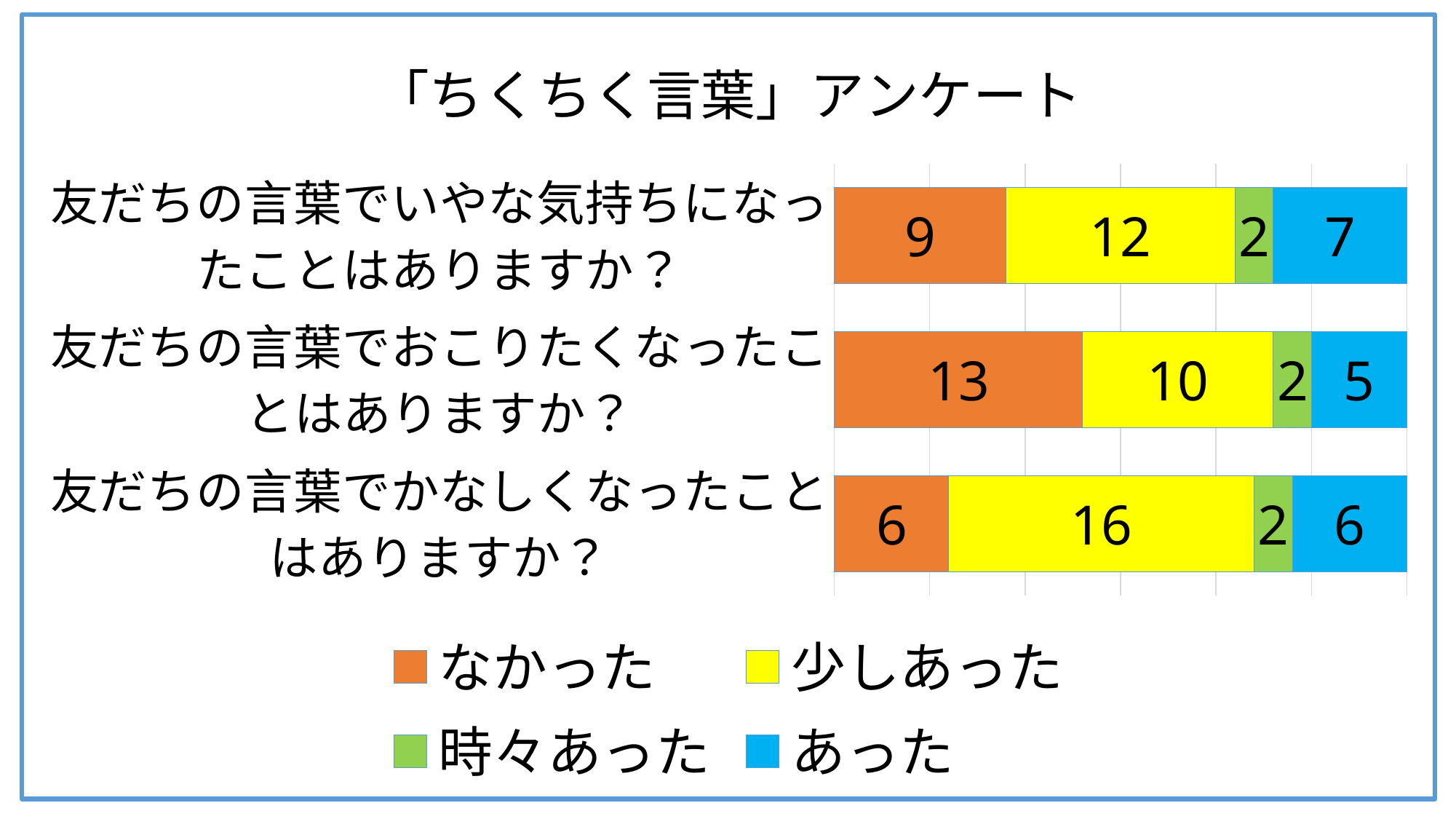
How many categories (questions) are plotted in the chart? 3 Which is larger for 友だちの言葉でいやな気持ちになったことはありますか？: なかった or 少しあった? 少しあった What is the value of 少しあった for 友だちの言葉でかなしくなったことはありますか？? 16 What is the total of the stacked bar for 友だちの言葉でおこりたくなったことはありますか？? 30 What type of chart is shown on the slide? stacked bar chart How many series does the legend list? 4 What is the title of the chart? 「ちくちく言葉」アンケート What is the difference between 少しあった and なかった for 友だちの言葉でかなしくなったことはありますか？? 10 What is the value of なかった for 友だちの言葉でおこりたくなったことはありますか？? 13 What is the value of あった for 友だちの言葉でいやな気持ちになったことはありますか？? 7 Which category has the highest value for なかった? 友だちの言葉でおこりたくなったことはありますか？ Which category has the lowest value for あった? 友だちの言葉でおこりたくなったことはありますか？